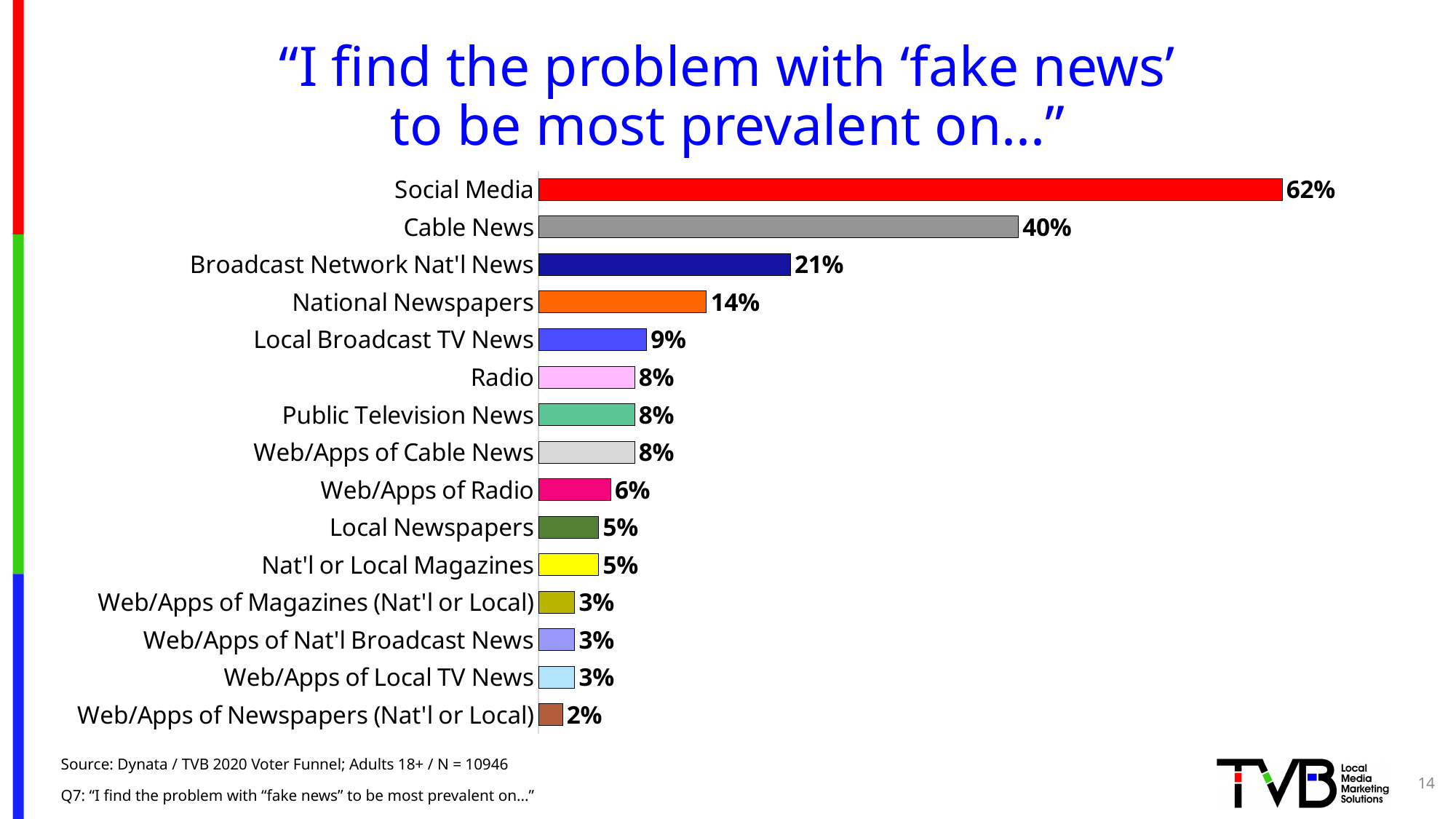
What percentage of respondents said the problem with 'fake news' is most prevalent on Social Media? 62% Which category has the highest value? Social Media What value is shown for National Newspapers? 14% Which has a larger value, Cable News or Broadcast Network Nat'l News? Cable News Which has a larger value, Local Broadcast TV News or Local Newspapers? Local Broadcast TV News Which category has the lowest value? Web/Apps of Newspapers (Nat'l or Local) What value is shown for Cable News? 40% What value is shown for Web/Apps of Radio? 6% How many categories are shown in the chart? 15 What kind of chart is shown on the slide? Bar chart What is the difference between the values for Social Media and Cable News? 22% What is the difference between the values for Broadcast Network Nat'l News and Local Broadcast TV News? 12%